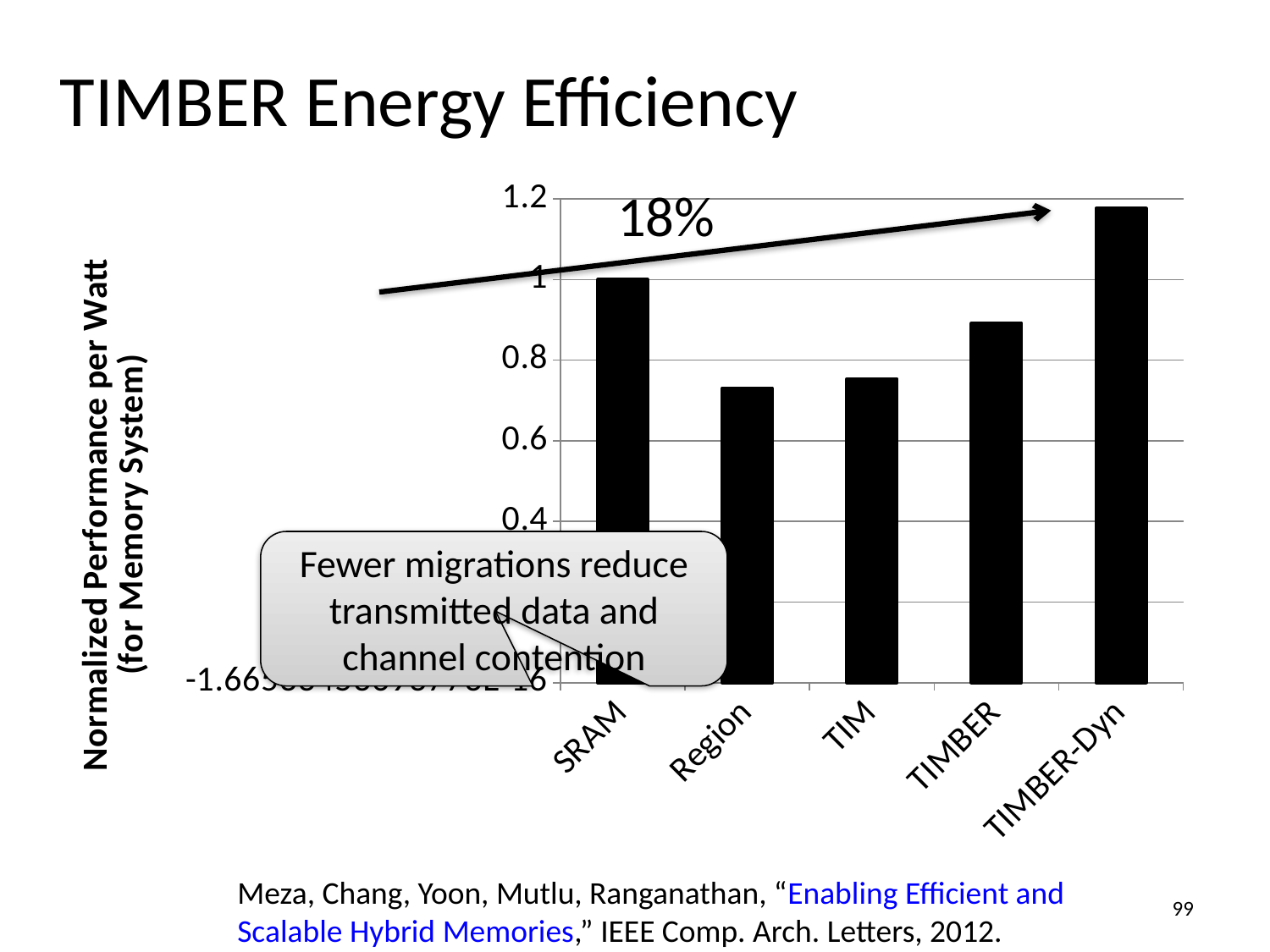
Is the value for TIMBER greater or less than 1? less Is the value for TIMBER greater or less than 0.8? greater Is the value for TIM greater or less than 0.8? less What kind of chart is shown on the slide? bar chart Which has a higher normalized performance per watt, TIMBER or TIM? TIMBER How many categories are plotted on the x axis? 5 What percentage improvement is annotated by the arrow on the chart? 18% Which category has the highest normalized performance per watt? TIMBER-Dyn Which has a higher normalized performance per watt, SRAM or Region? SRAM What is the normalized performance per watt for SRAM? 1